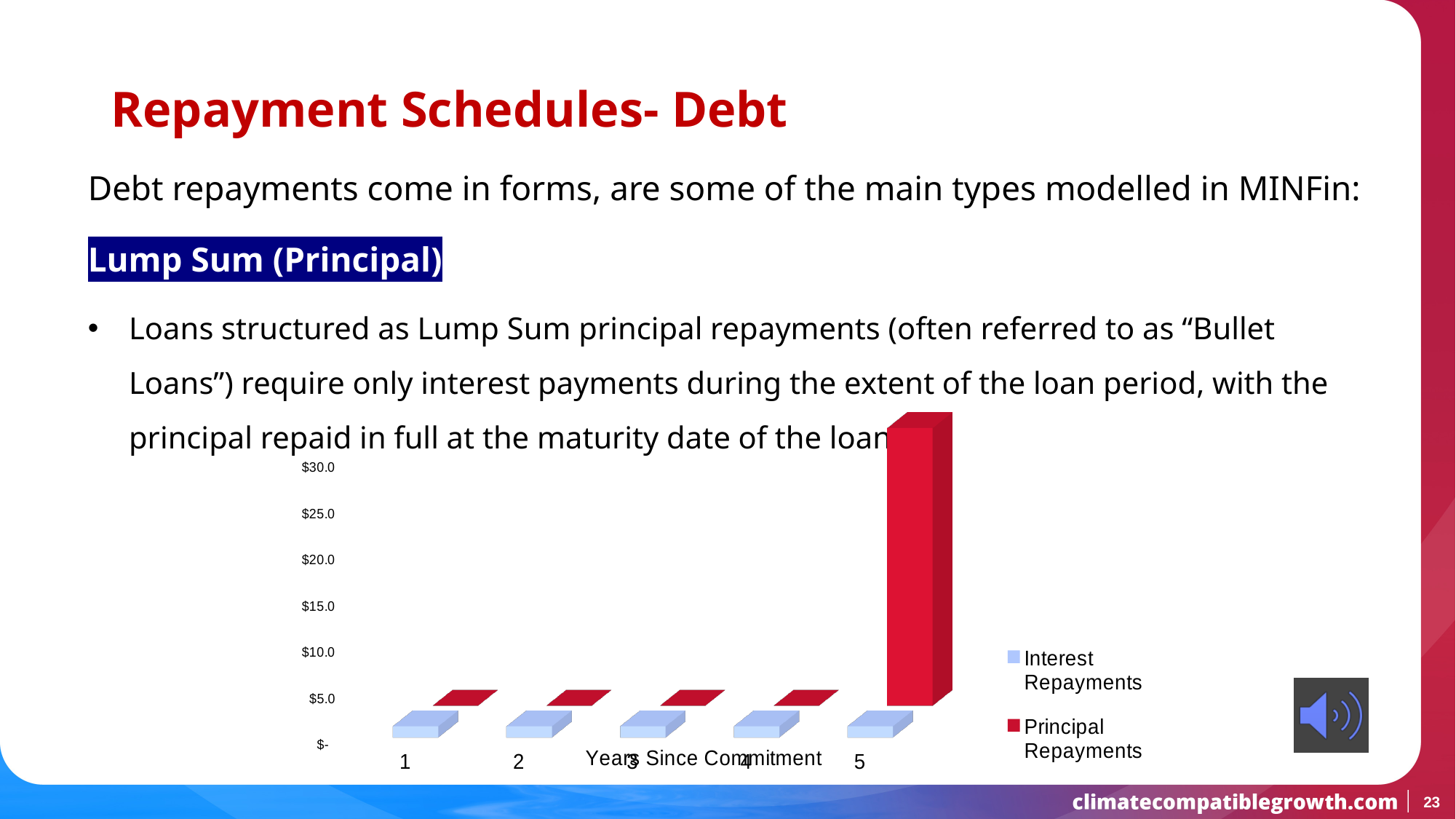
In which year is the Principal Repayments value highest? 5 How many years are shown along the x axis of the chart? 5 Is the Principal Repayments value in year 5 greater or less than $25.0? greater Which series is shown in red in the chart? Principal Repayments Is the Interest Repayments value in year 3 greater or less than $10.0? less Is the Interest Repayments value in year 1 greater or less than $5.0? less In year 5, which is larger: Interest Repayments or Principal Repayments? Principal Repayments How many series does the chart legend list? 2 What kind of chart is shown on the slide? bar chart What is the title of the x axis of the chart? Years Since Commitment